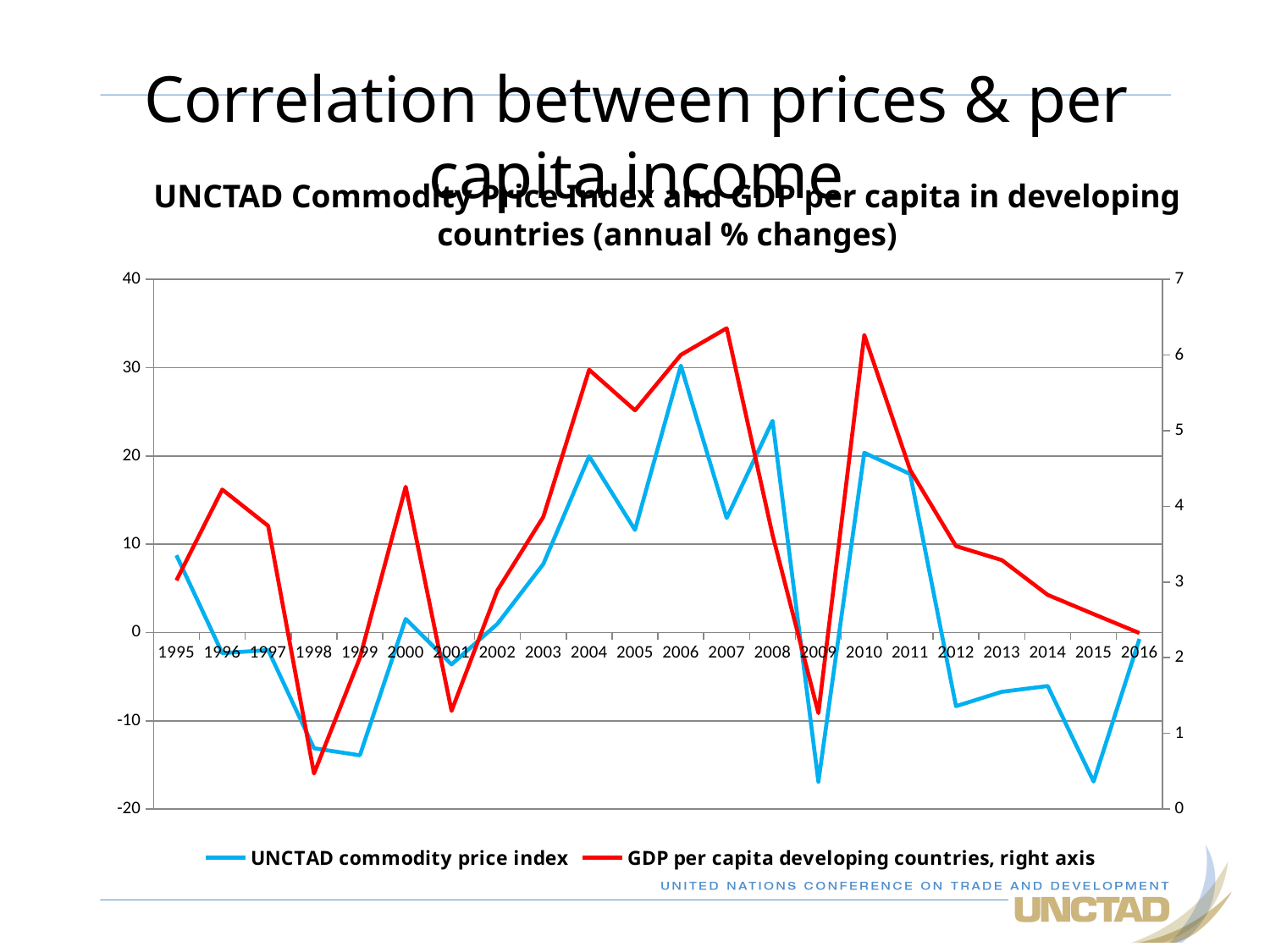
In which year is GDP per capita in developing countries at its lowest? 1998 Which year has the higher UNCTAD commodity price index value, 2006 or 2008? 2006 How many series does the legend list? 2 Is the value of GDP per capita developing countries in 2004 greater or less than 5 on the right axis? greater Which series is plotted against the right axis? GDP per capita developing countries Is the value of the UNCTAD commodity price index in 2006 greater or less than 20? greater What colour is the line for the UNCTAD commodity price index? Blue How many years are plotted along the x axis? 22 What kind of chart is shown on the slide? Line chart Does the GDP per capita developing countries line rise or fall from 2010 to 2016? Fall Is the value of the UNCTAD commodity price index in 2009 greater or less than -10? less In which year does the UNCTAD commodity price index reach its highest value? 2006